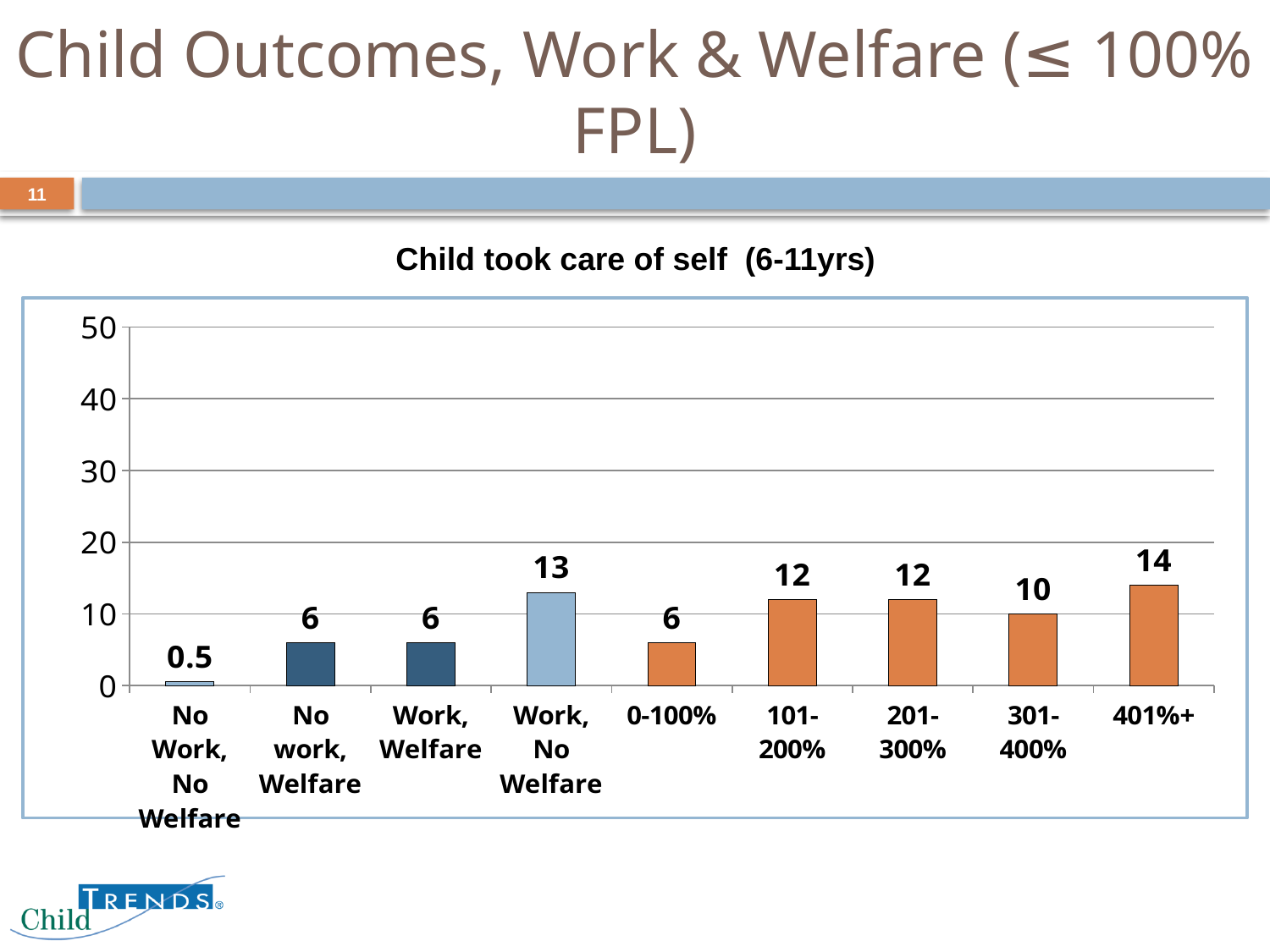
Which category has the highest value? 401%+ What is the value for the '401%+' category? 14 What is the difference between the values for '401%+' and '0-100%'? 8 Which category has the lowest value? No Work, No Welfare What is the value for the 'Work, No Welfare' category? 13 What is the value for the 'No Work, No Welfare' category? 0.5 What is the value for the '301-400%' category? 10 Is the value for '201-300%' greater or less than 20? less What kind of chart is shown on the slide? bar chart Which is larger, the value for 'Work, No Welfare' or the value for '101-200%'? Work, No Welfare What is the title of the chart? Child took care of self (6-11yrs) How many categories are shown on the x axis? 9